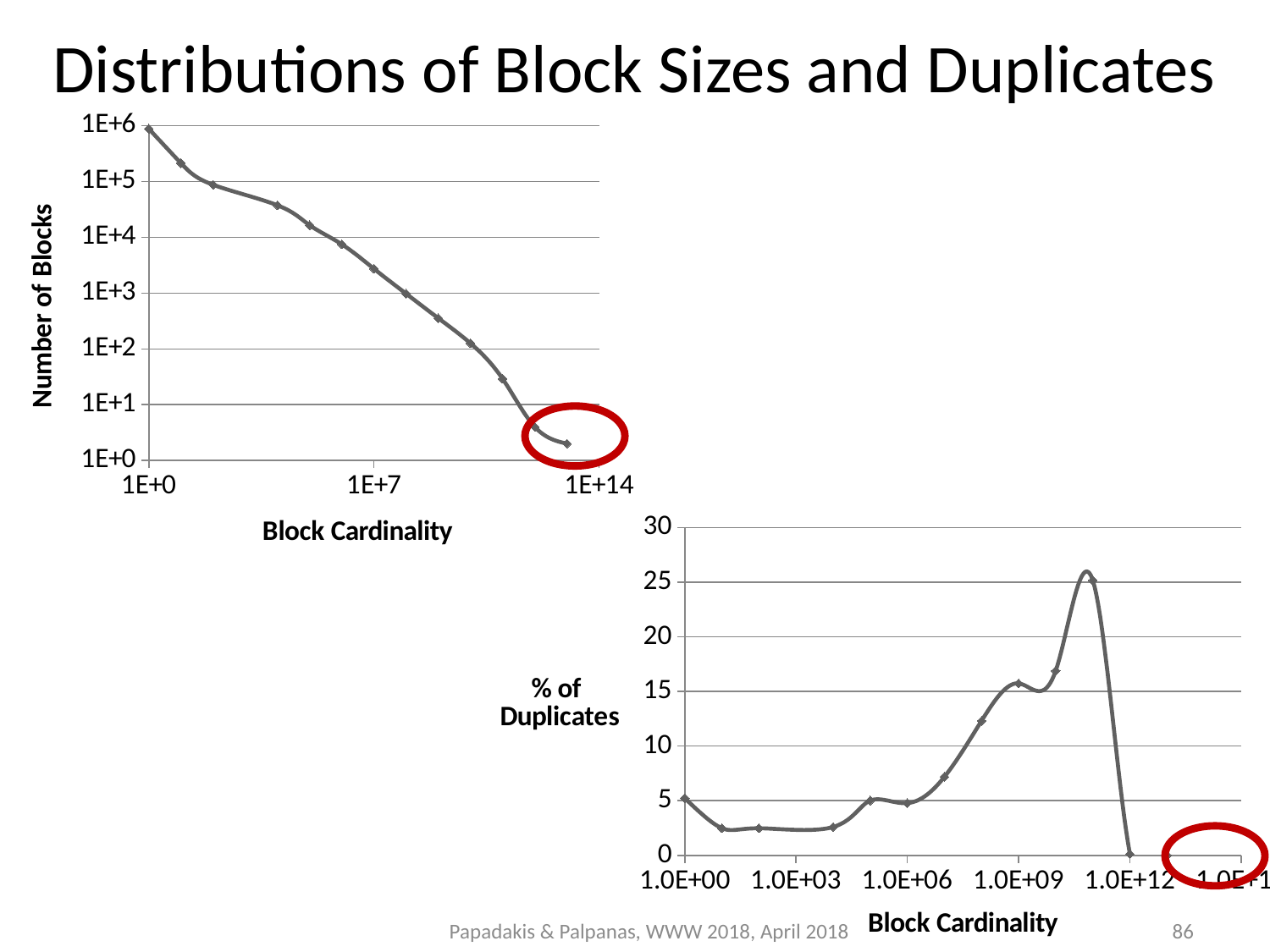
In the top-left chart (Number of Blocks), is the value of the last (rightmost) point greater or less than 1E+1? less What kind of chart is the top-left chart titled with y-axis 'Number of Blocks'? line chart In the top-left chart (Number of Blocks), do the values rise or fall as Block Cardinality increases along the x axis? fall What is the x-axis title of the top-left chart? Block Cardinality In the bottom-right chart (% of Duplicates), is the value at Block Cardinality 1.0E+12 greater or less than 5? less In the top-left chart (Number of Blocks), is the value at Block Cardinality 1E+7 greater or less than 1E+4? less What kind of chart is the bottom-right chart with y-axis '% of Duplicates'? line chart What is the title of the slide? Distributions of Block Sizes and Duplicates